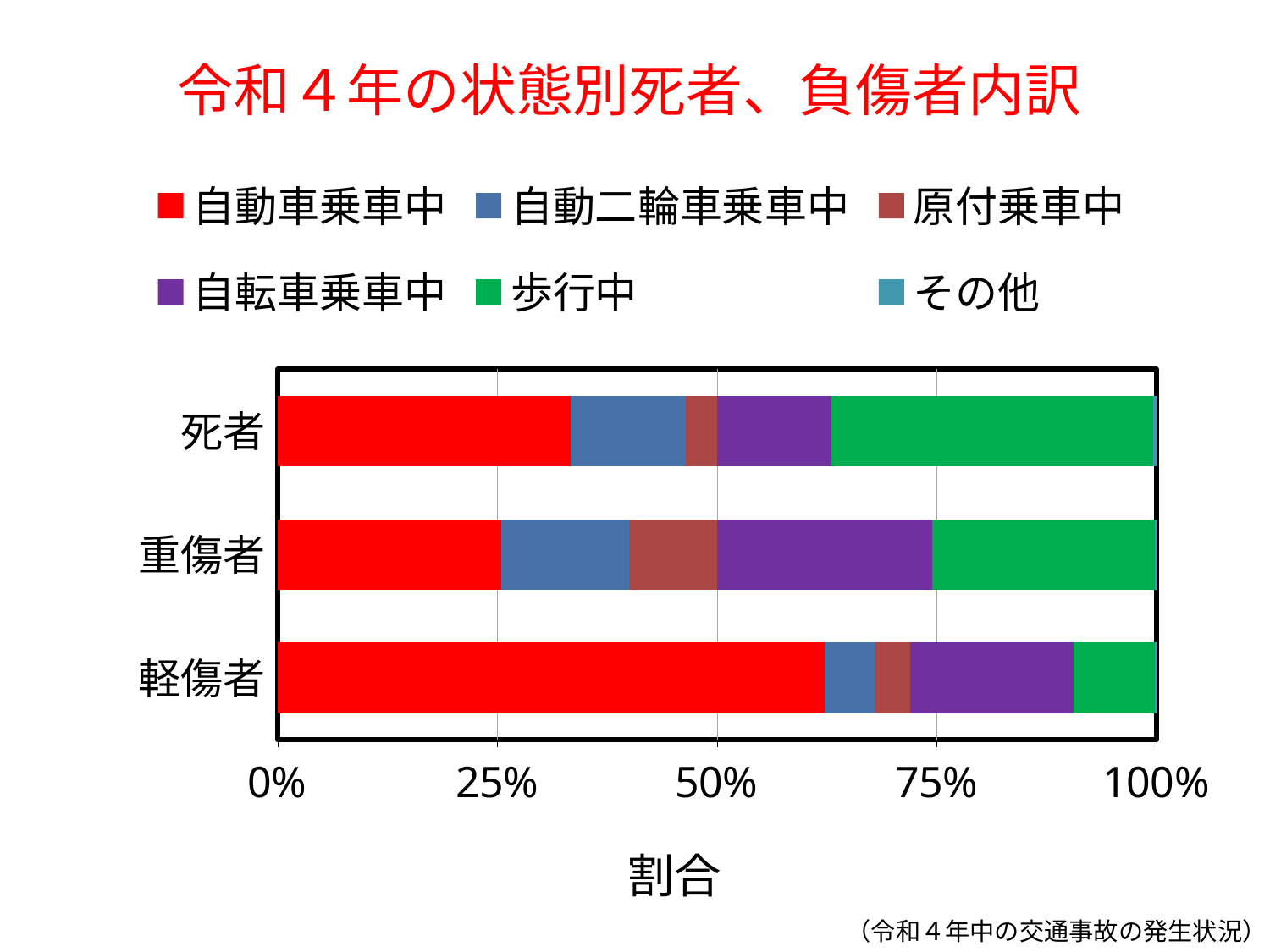
What is the label of the horizontal axis? 割合 Is the 歩行中 share for 死者 greater or less than 25%? greater How many categories are shown on the vertical axis of the chart? 3 What is the title of the chart on the slide? 令和４年の状態別死者、負傷者内訳 What kind of chart is shown on the slide? Stacked bar chart How many series does the legend list? 6 Is the 自動車乗車中 share for 死者 greater or less than 50%? less Which category has the largest 自転車乗車中 share? 重傷者 Which category has the largest 自動車乗車中 share: 死者 or 軽傷者? 軽傷者 Which category has the smallest 自動車乗車中 share? 重傷者 Which category has the largest 歩行中 share? 死者 Is the 自動車乗車中 share for 軽傷者 greater or less than 50%? greater